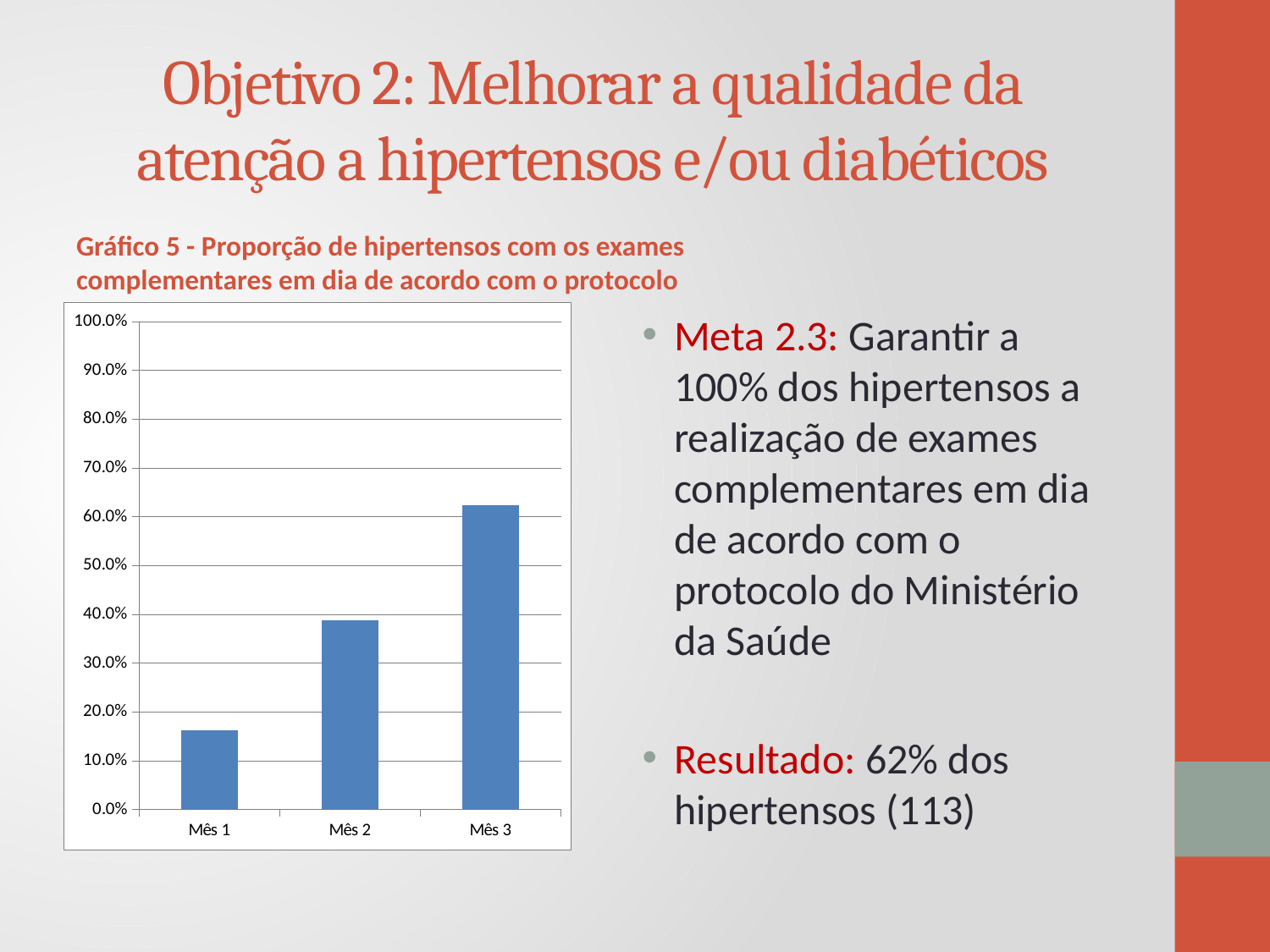
What kind of chart is shown on the slide? bar chart Is the value for Mês 2 greater or less than 30.0%? greater Do the values rise or fall from Mês 1 to Mês 3? rise How many categories are plotted on the x axis of the chart? 3 What is the title of the chart (Gráfico 5)? Proporção de hipertensos com os exames complementares em dia de acordo com o protocolo Is the value for Mês 1 greater or less than 20.0%? less What is the highest value shown on the chart's y axis? 100.0% Which month has the lowest bar in the chart? Mês 1 Which is larger, the value for Mês 1 or the value for Mês 2? Mês 2 Which month has the highest bar in the chart? Mês 3 Is the value for Mês 3 greater or less than 70.0%? less